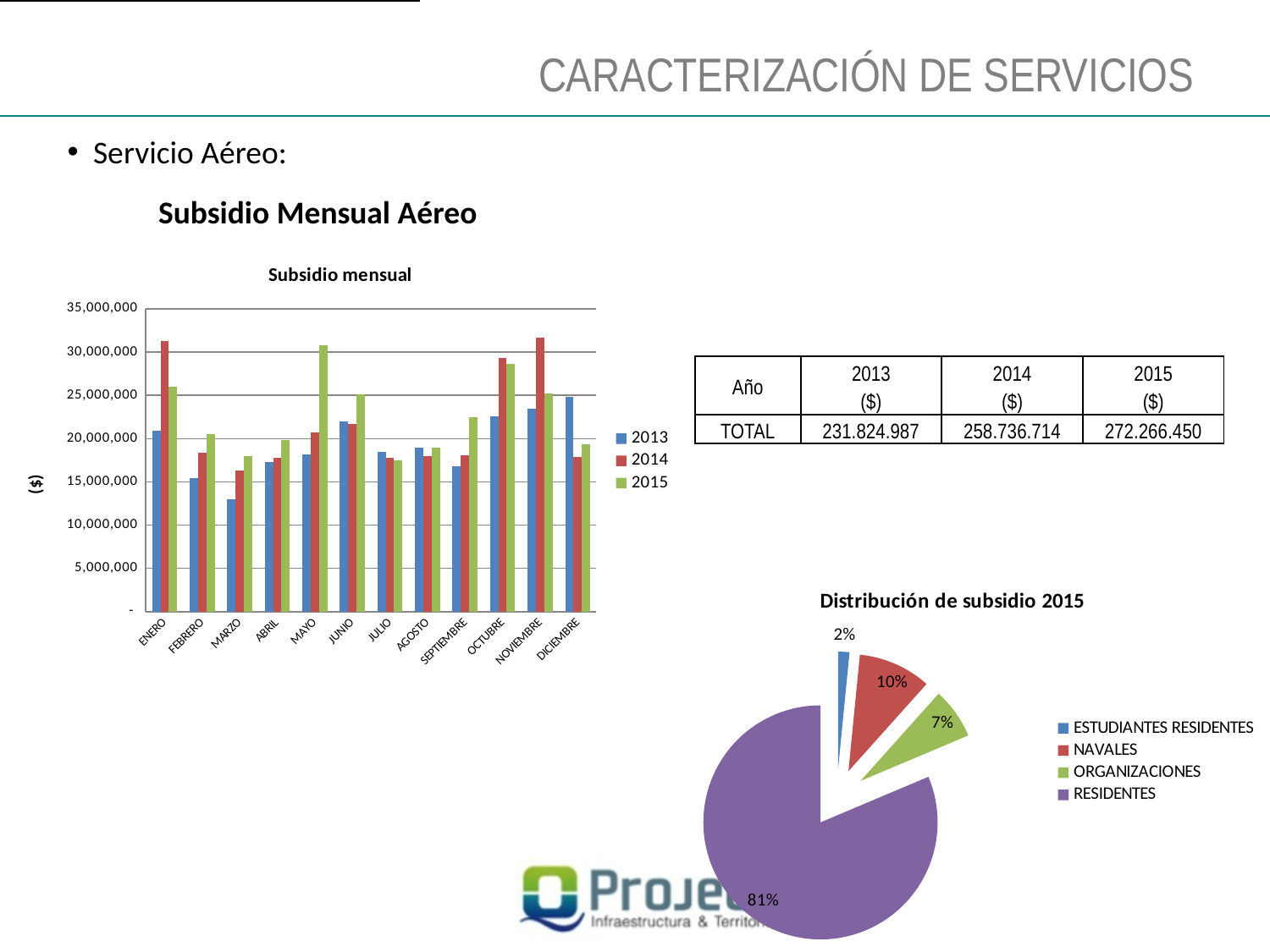
How many series does the legend of the 'Subsidio mensual' chart list? 3 In the 'Distribución de subsidio 2015' pie chart, how many slices are there? 4 In the 'Distribución de subsidio 2015' pie chart, which category has the smallest slice? ESTUDIANTES RESIDENTES In the 'Distribución de subsidio 2015' pie chart, what share does ESTUDIANTES RESIDENTES have? 2% In the 'Subsidio mensual' chart, is the 2014 value for ENERO greater or less than 30,000,000? greater In the 'Distribución de subsidio 2015' pie chart, what is the difference between the NAVALES share and the ORGANIZACIONES share? 3% In the 'Subsidio mensual' chart, is the 2013 value for MARZO greater or less than 15,000,000? less In the 'Distribución de subsidio 2015' pie chart, what share does ORGANIZACIONES have? 7% In the 'Subsidio mensual' chart, which month has the lowest 2013 value? MARZO In the 'Distribución de subsidio 2015' pie chart, what share does RESIDENTES have? 81% What kind of chart is the 'Subsidio mensual' chart? Bar chart